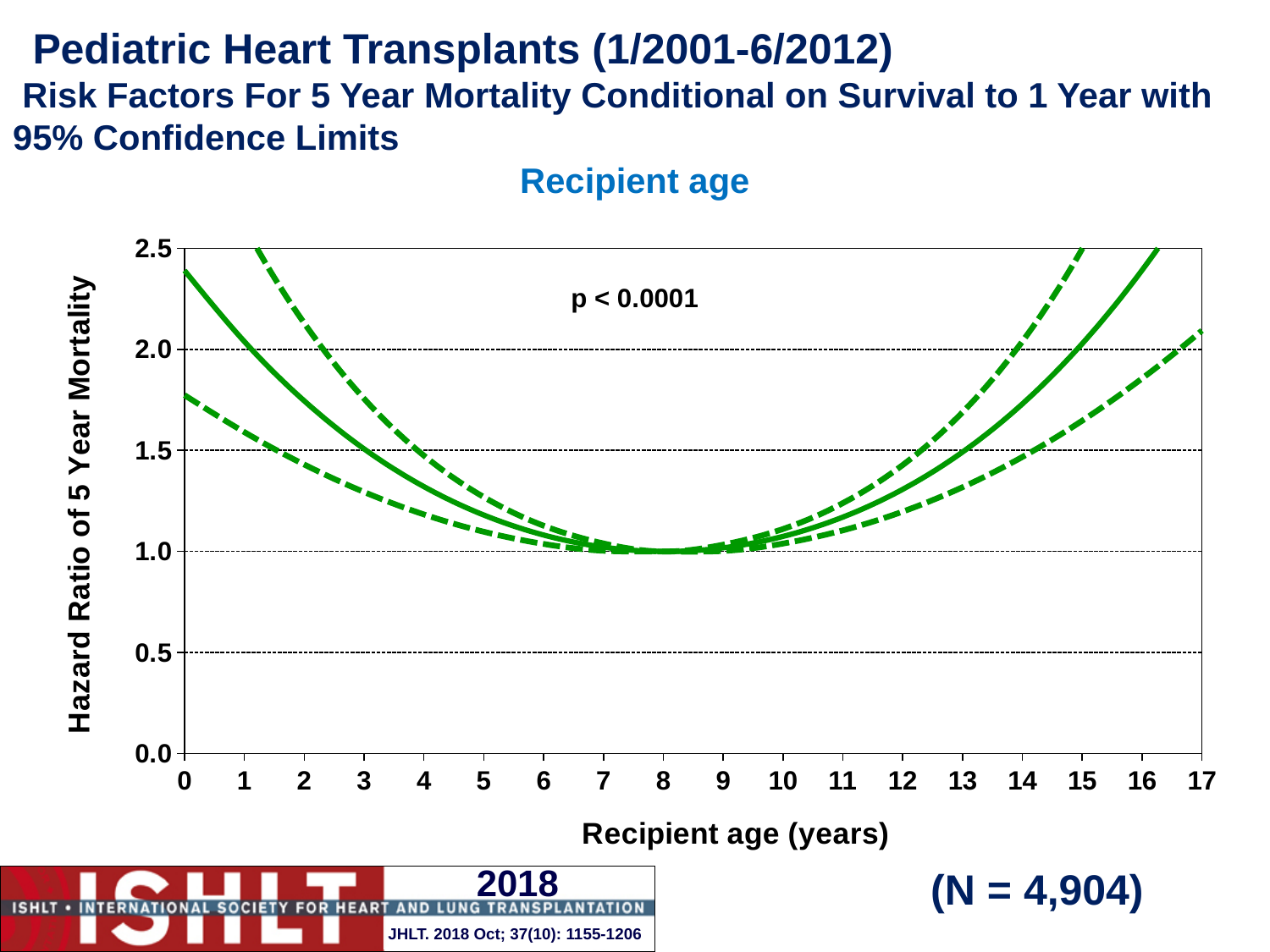
Does the solid hazard ratio line rise or fall as recipient age increases from 8 to 17 years? rise At which recipient age does the solid hazard ratio line reach its lowest point? 8 At recipient age 4, is the hazard ratio on the solid line greater or less than 1.5? less Which is larger on the solid line: the hazard ratio at recipient age 1 or at recipient age 6? age 1 At recipient age 12, is the hazard ratio on the solid line greater or less than 1.5? less At recipient age 2, is the hazard ratio on the solid line greater or less than 1.5? greater What is the N value shown on the slide? N = 4,904 What kind of chart is shown on the slide? line chart Does the solid hazard ratio line rise or fall as recipient age increases from 0 to 8 years? fall What p-value is printed on the chart? p < 0.0001